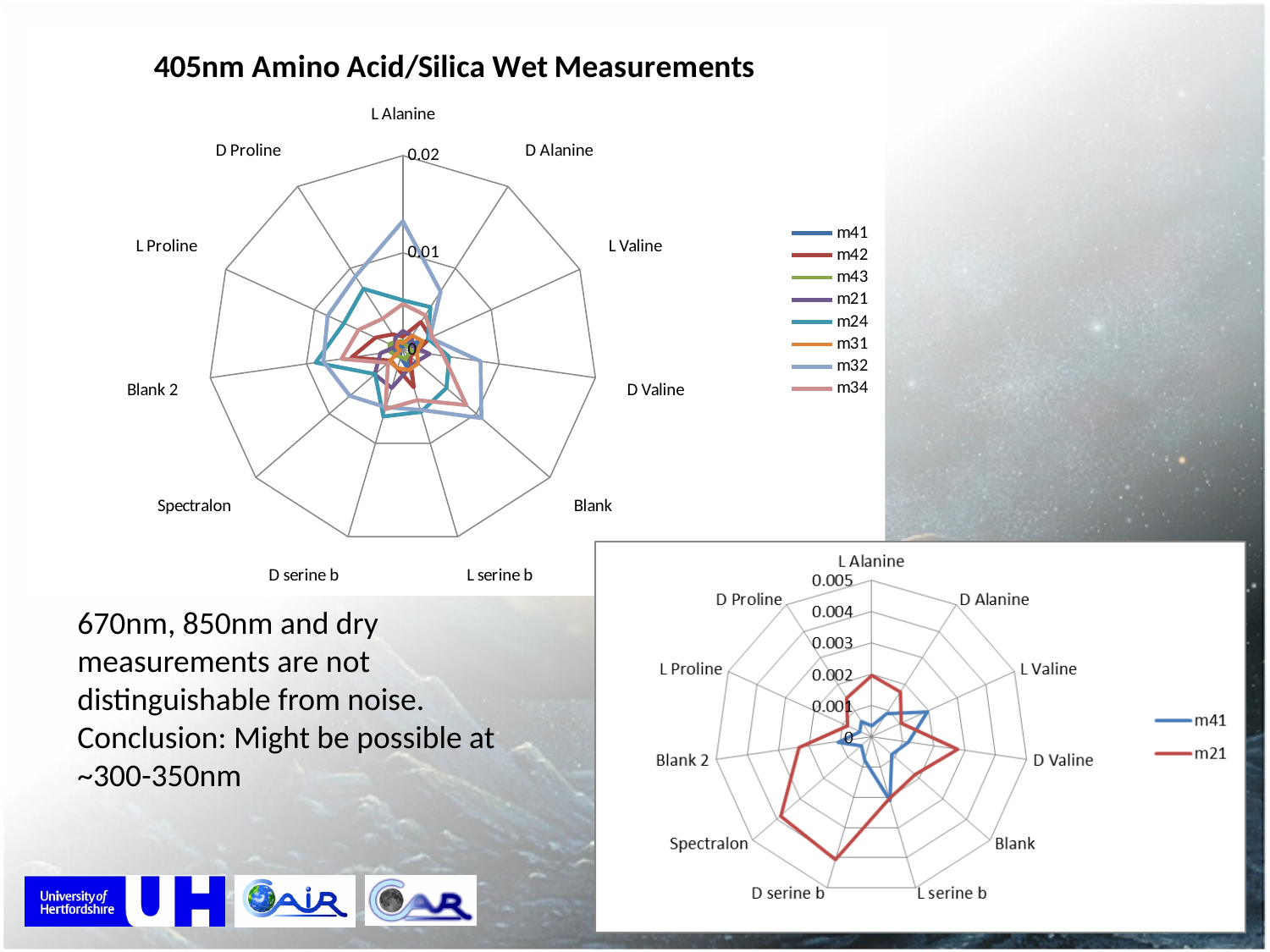
How many series does the legend of the bottom-right chart list? 2 What is the title of the top chart? 405nm Amino Acid/Silica Wet Measurements What kind of chart is the top chart titled '405nm Amino Acid/Silica Wet Measurements'? Radar chart In the top chart, which series reaches the highest value for L Alanine? m32 In the bottom-right chart, which series has the larger value for Spectralon, m41 or m21? m21 How many categories (axes) does the top chart have? 11 In the top chart, is the value of m32 for L Alanine greater or less than 0.01? greater How many series does the legend of the top chart list? 8 What is the maximum value shown on the axis scale of the bottom-right chart? 0.005 In the bottom-right chart, is the value of m21 for Spectralon greater or less than 0.003? greater